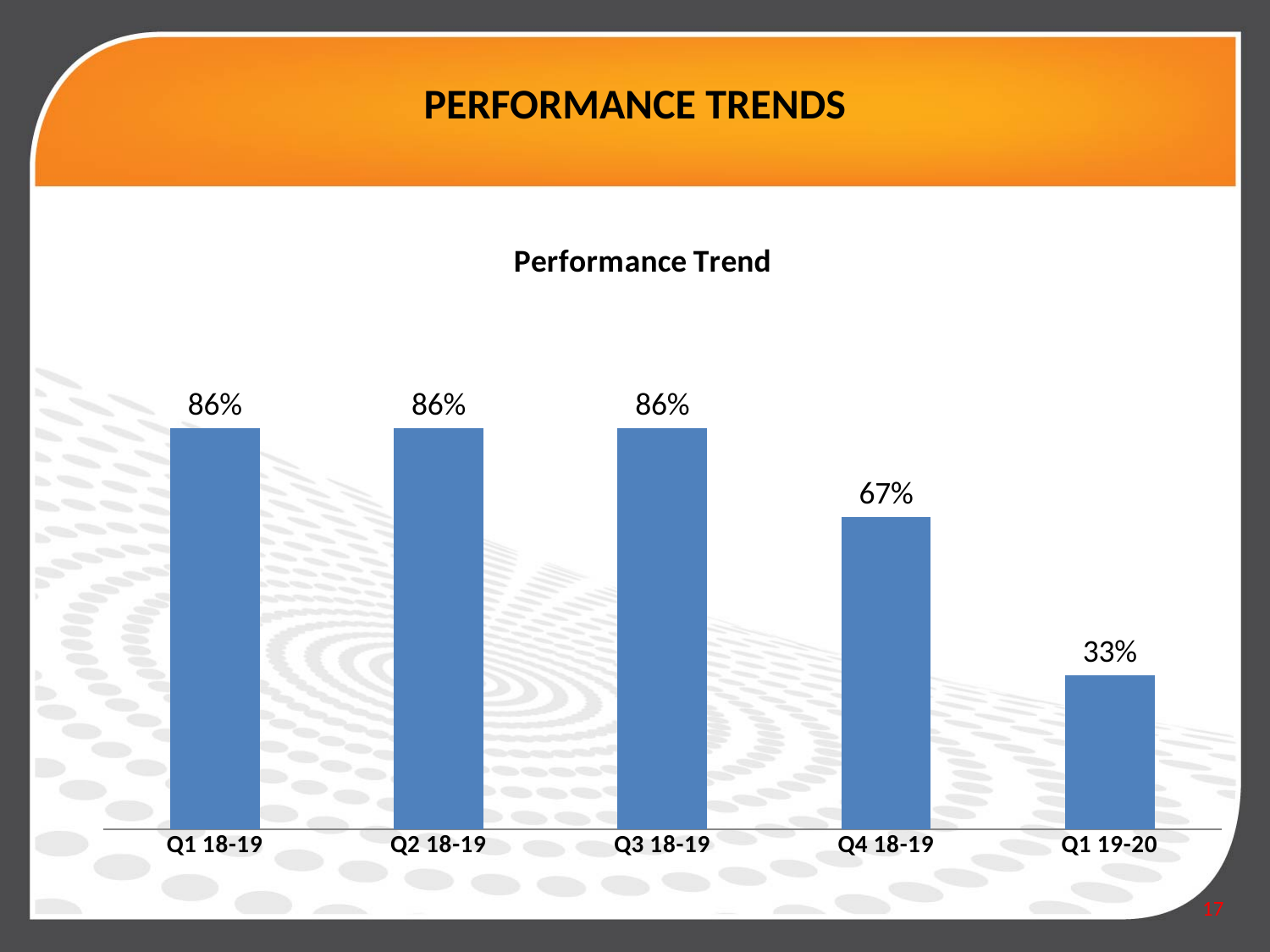
How many categories are shown on the x axis? 5 Do the values rise or fall from Q3 18-19 to Q1 19-20? fall What is the difference between the values for Q3 18-19 and Q4 18-19? 19% What is the difference between the values for Q4 18-19 and Q1 19-20? 34% Which is larger, the value for Q4 18-19 or the value for Q1 19-20? Q4 18-19 What is the title of the chart? Performance Trend What is the value for Q2 18-19? 86% What is the value for Q1 19-20? 33% What is the value for Q4 18-19? 67% How many categories share the highest value of 86%? 3 What kind of chart is shown? bar chart Which category has the lowest value? Q1 19-20